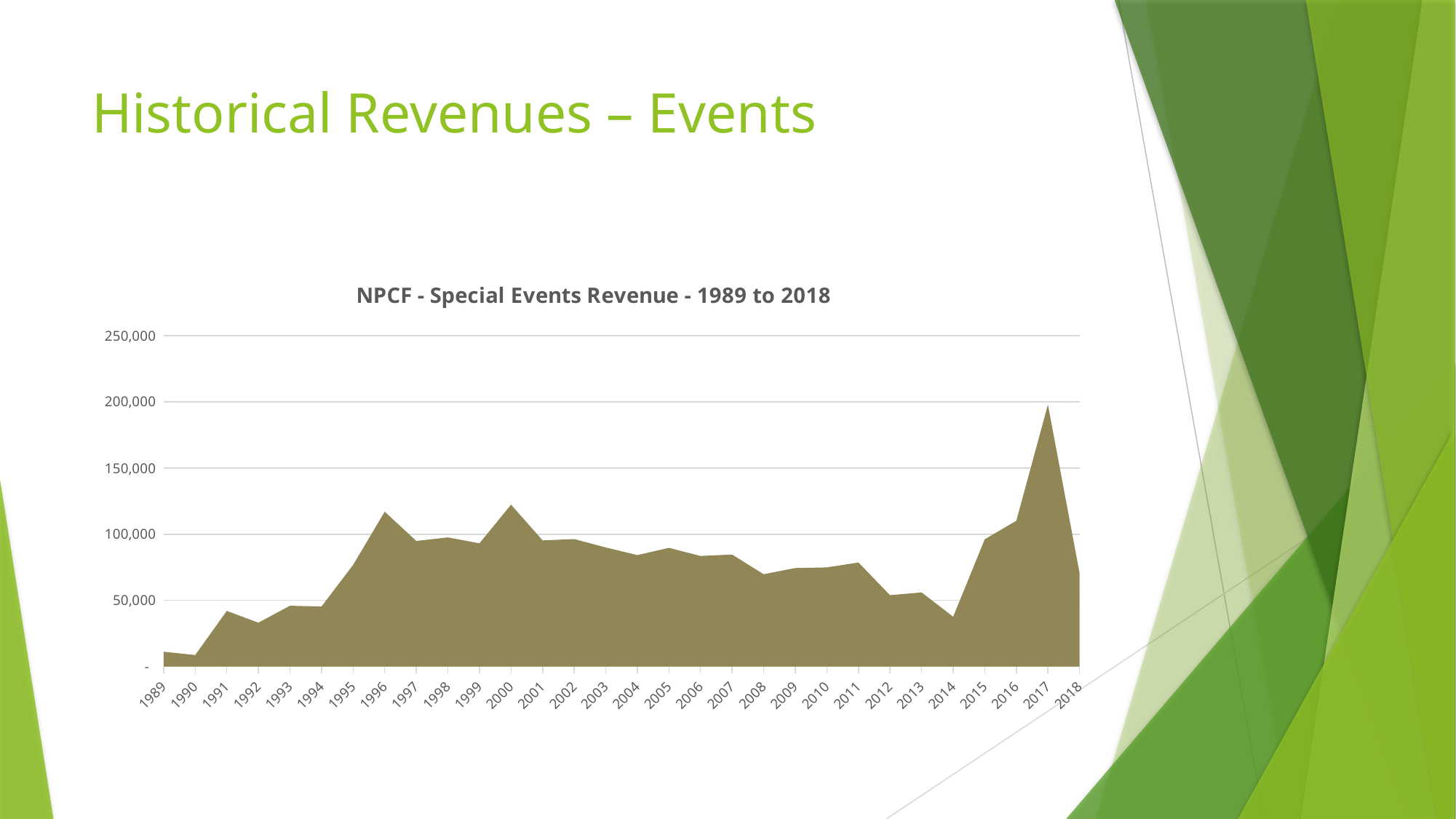
How many years are plotted along the x axis of the chart? 30 Which year has the larger revenue, 1994 or 1996? 1996 What is the highest value shown on the vertical axis? 250,000 Is the value for 2008 greater or less than 100,000? less Is the value for 2014 greater or less than 50,000? less What kind of chart is shown on the slide? Area chart What is the title of the chart? NPCF - Special Events Revenue - 1989 to 2018 Which year has the highest special events revenue? 2017 Which year has the larger revenue, 2000 or 2017? 2017 Do the values rise or fall from 2014 to 2017? rise Is the value for 1996 greater or less than 100,000? greater